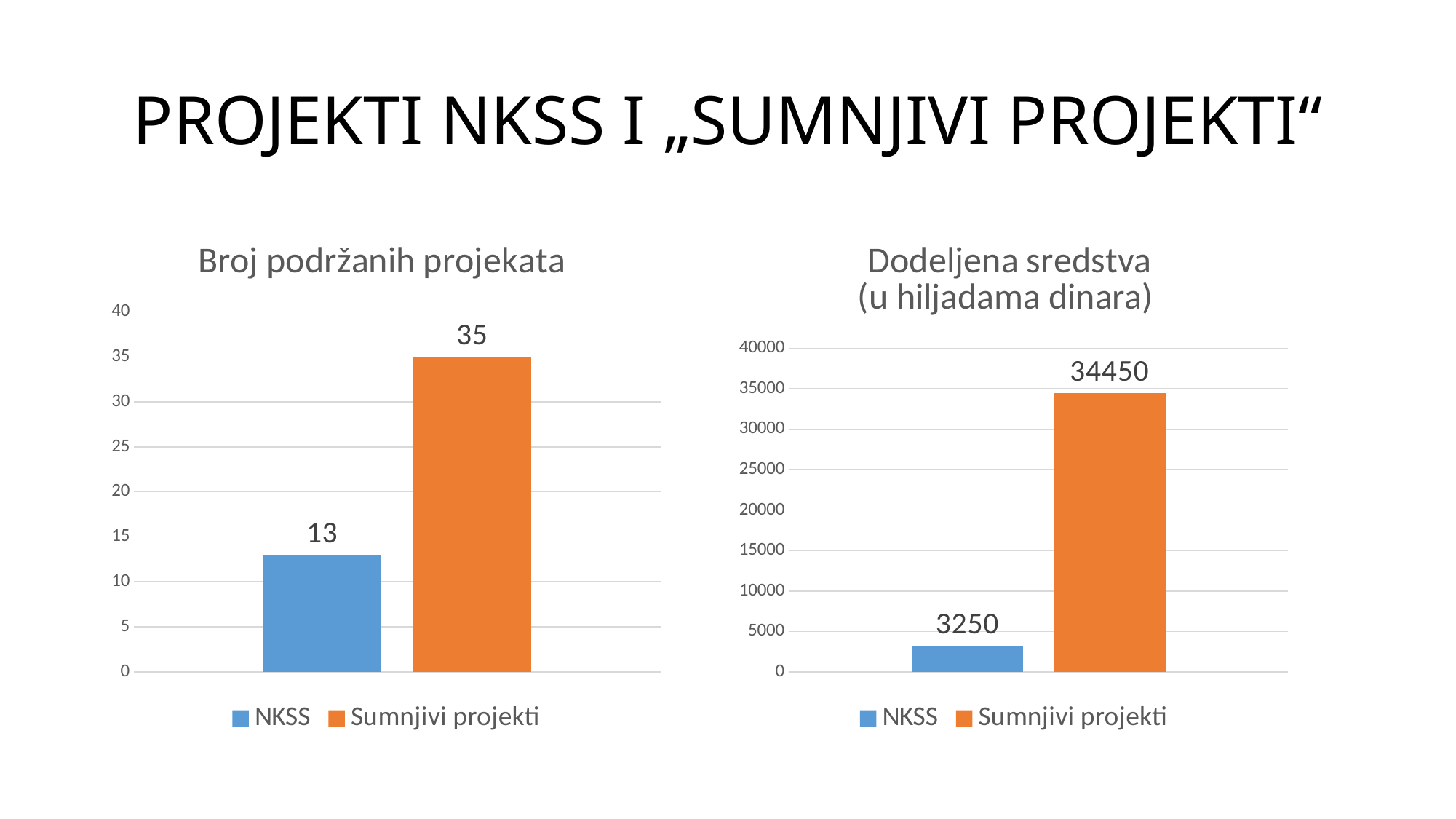
In the chart titled "Broj podržanih projekata", what colour is the NKSS bar? blue In the chart titled "Broj podržanih projekata", what is the value for NKSS? 13 In the chart titled "Dodeljena sredstva (u hiljadama dinara)", what is the value for NKSS? 3250 In the chart titled "Broj podržanih projekata", which series has the higher value? Sumnjivi projekti In the chart titled "Broj podržanih projekata", what is the difference between the Sumnjivi projekti value and the NKSS value? 22 In the chart titled "Dodeljena sredstva (u hiljadama dinara)", what is the difference between the Sumnjivi projekti value and the NKSS value? 31200 In the chart titled "Dodeljena sredstva (u hiljadama dinara)", which series has the lower value? NKSS In the chart titled "Dodeljena sredstva (u hiljadama dinara)", is the value for NKSS greater or less than 5000? less In the chart titled "Dodeljena sredstva (u hiljadama dinara)", what is the value for Sumnjivi projekti? 34450 In the chart titled "Broj podržanih projekata", what is the value for Sumnjivi projekti? 35 How many series does the legend of the chart titled "Broj podržanih projekata" list? 2 What kind of chart is the chart titled "Dodeljena sredstva (u hiljadama dinara)"? bar chart